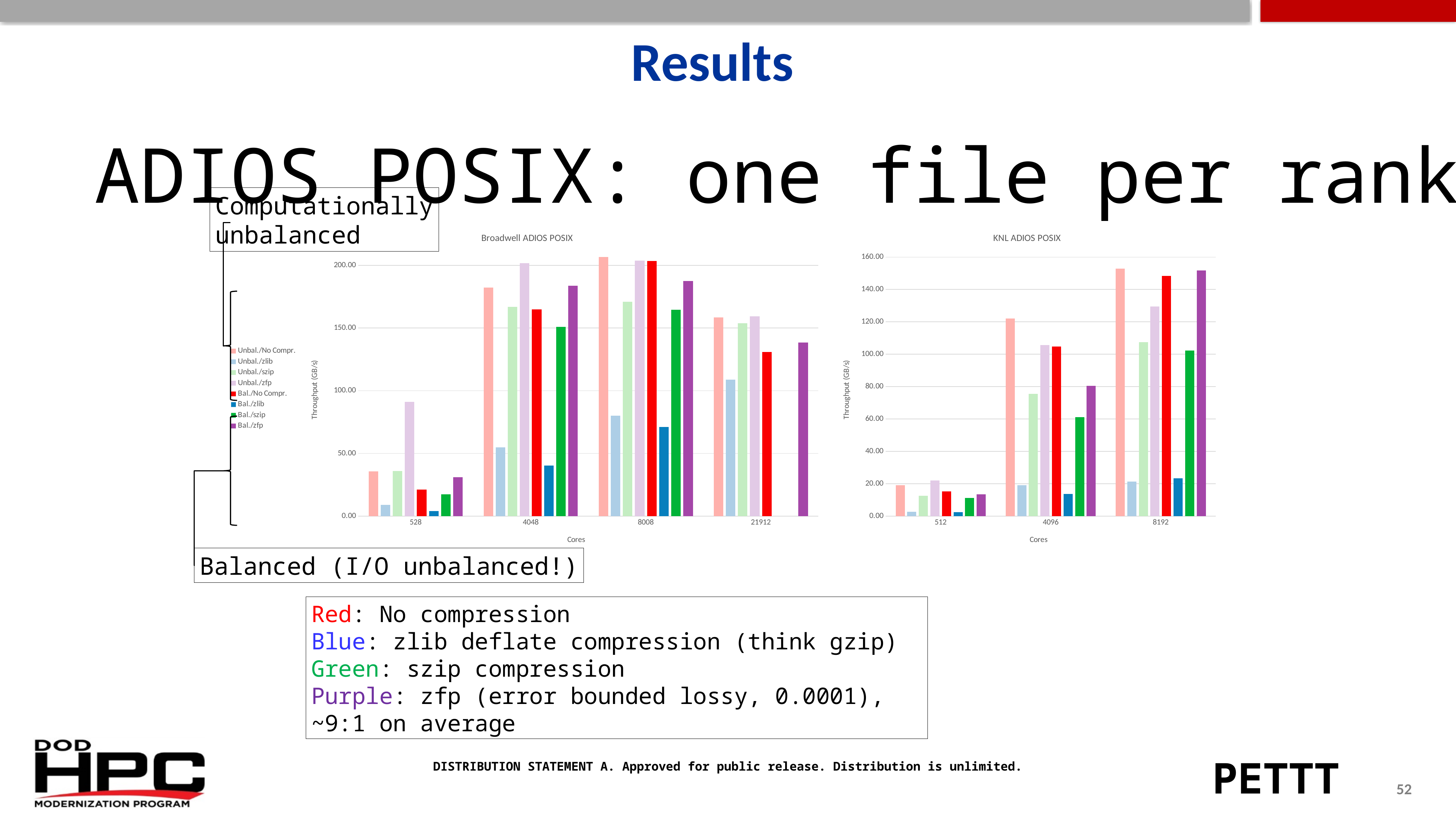
How many core counts are shown on the x axis of the Broadwell ADIOS POSIX chart? 4 In the Broadwell ADIOS POSIX chart, is the Bal./zlib value at 4048 cores greater or less than 50? less In the Broadwell ADIOS POSIX chart, is the Unbal./zfp value at 528 cores greater or less than 100? less In the KNL ADIOS POSIX chart, does the Bal./No Compr. throughput rise or fall as the core count increases? rise How many core counts are shown on the x axis of the KNL ADIOS POSIX chart? 3 In the Broadwell ADIOS POSIX chart, at which core count is the Unbal./No Compr. throughput highest? 8008 In the KNL ADIOS POSIX chart, is the Bal./No Compr. value at 8192 cores greater or less than 140? greater What kind of chart is the Broadwell ADIOS POSIX chart? bar chart In the Broadwell ADIOS POSIX chart at 528 cores, which is larger: Unbal./zfp or Bal./zfp? Unbal./zfp How many series does the legend of the Broadwell ADIOS POSIX chart list? 8